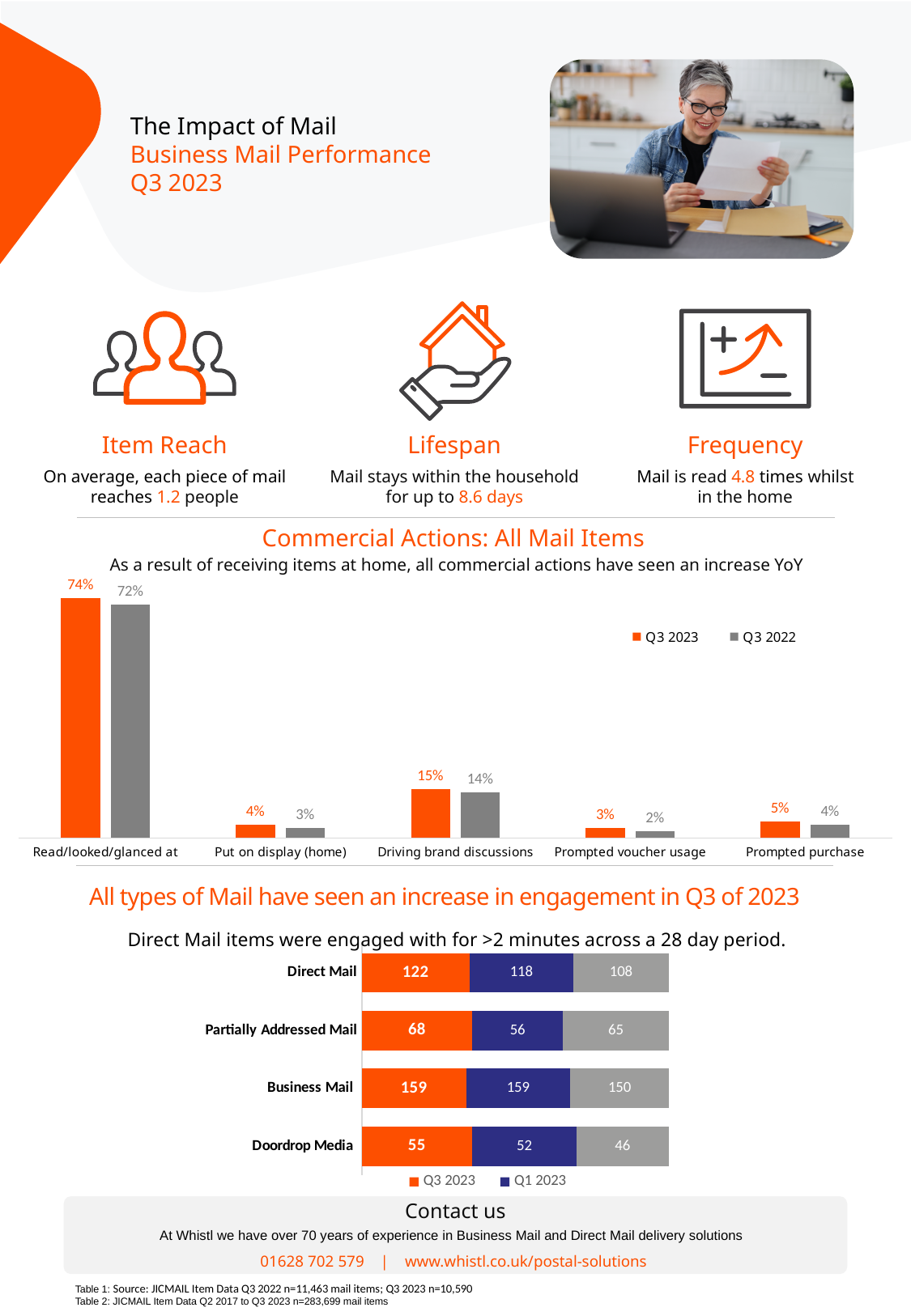
What kind of chart is the lower chart showing Direct Mail, Partially Addressed Mail, Business Mail and Doordrop Media? Stacked bar chart In the lower chart showing Direct Mail, Partially Addressed Mail, Business Mail and Doordrop Media, which mail type has the lowest Q3 2023 value? Doordrop Media In the Commercial Actions: All Mail Items chart, how many series does the legend list? 2 In the Commercial Actions: All Mail Items chart, what is the Q3 2023 value for Prompted purchase? 5% In the Commercial Actions: All Mail Items chart, how many categories are shown on the x axis? 5 In the Commercial Actions: All Mail Items chart, which category has the lowest Q3 2022 value? Prompted voucher usage In the Commercial Actions: All Mail Items chart, which category has the highest Q3 2023 value? Read/looked/glanced at In the Commercial Actions: All Mail Items chart, what is the Q3 2022 value for Driving brand discussions? 14% In the lower chart showing Direct Mail, Partially Addressed Mail, Business Mail and Doordrop Media, what is the Q3 2023 value for Business Mail? 159 In the lower chart showing Direct Mail, Partially Addressed Mail, Business Mail and Doordrop Media, what is the Q1 2023 value for Partially Addressed Mail? 56 In the Commercial Actions: All Mail Items chart, what is the Q3 2023 value for Read/looked/glanced at? 74% In the Commercial Actions: All Mail Items chart, what is the difference between the Q3 2023 and Q3 2022 values for Read/looked/glanced at? 2%